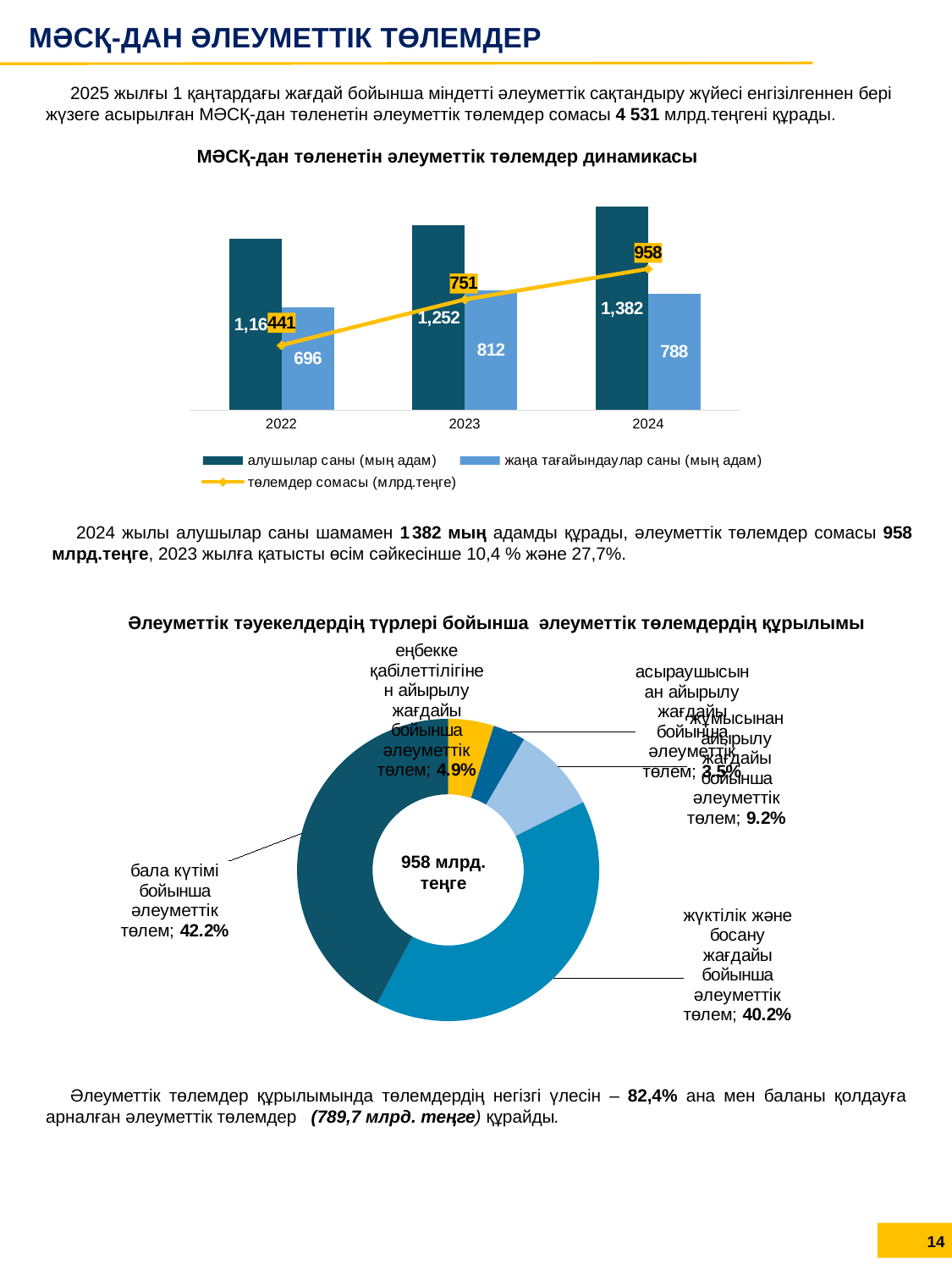
In the chart 'Әлеуметтік тәуекелдердің түрлері бойынша әлеуметтік төлемдердің құрылымы', what share is 'бала күтімі бойынша әлеуметтік төлем'? 42.2% In the chart 'МӘСҚ-дан төленетін әлеуметтік төлемдер динамикасы', what is the value of 'төлемдер сомасы (млрд.теңге)' for 2024? 958 In the chart 'МӘСҚ-дан төленетін әлеуметтік төлемдер динамикасы', does 'төлемдер сомасы (млрд.теңге)' rise or fall from 2022 to 2024? rise In the chart 'МӘСҚ-дан төленетін әлеуметтік төлемдер динамикасы', what is the value of 'жаңа тағайындаулар саны (мың адам)' for 2023? 812 In the chart 'МӘСҚ-дан төленетін әлеуметтік төлемдер динамикасы', which year has the lowest 'төлемдер сомасы (млрд.теңге)'? 2022 In the chart 'МӘСҚ-дан төленетін әлеуметтік төлемдер динамикасы', what is the value of 'алушылар саны (мың адам)' for 2024? 1,382 How many series does the legend of the chart 'МӘСҚ-дан төленетін әлеуметтік төлемдер динамикасы' list? 3 How many years are shown on the x axis of the chart 'МӘСҚ-дан төленетін әлеуметтік төлемдер динамикасы'? 3 In the chart 'Әлеуметтік тәуекелдердің түрлері бойынша әлеуметтік төлемдердің құрылымы', what total value is shown in the centre of the doughnut? 958 млрд. теңге What kind of chart is 'Әлеуметтік тәуекелдердің түрлері бойынша әлеуметтік төлемдердің құрылымы'? doughnut chart In the chart 'МӘСҚ-дан төленетін әлеуметтік төлемдер динамикасы', what is the difference in 'төлемдер сомасы (млрд.теңге)' between 2024 and 2023? 207 In the chart 'МӘСҚ-дан төленетін әлеуметтік төлемдер динамикасы', which is larger: 'жаңа тағайындаулар саны' in 2023 or in 2024? 2023